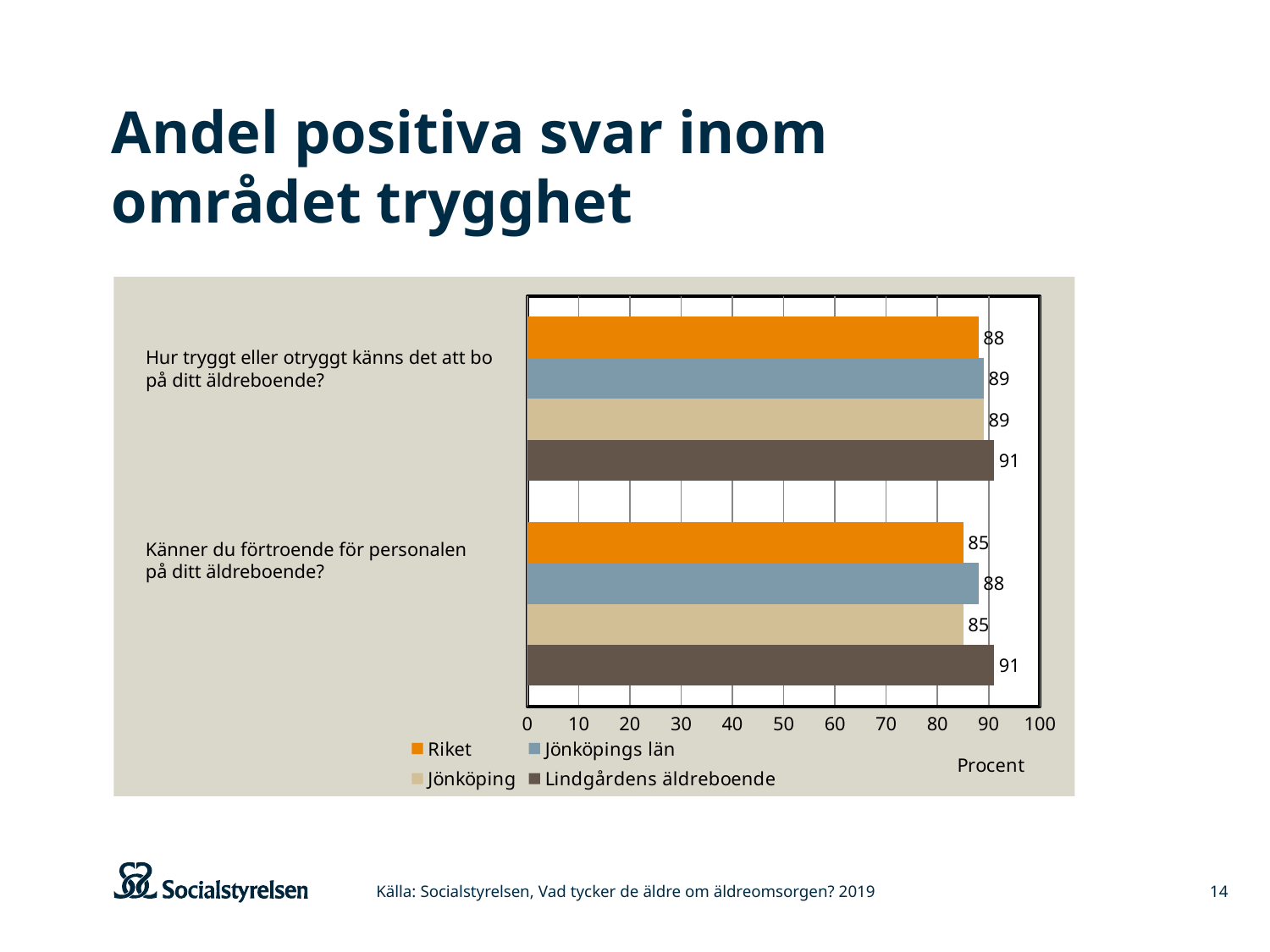
What is the value for Riket for the question "Hur tryggt eller otryggt känns det att bo på ditt äldreboende?"? 88 What unit label is shown under the x axis? Procent Which series has the lowest value for the question "Hur tryggt eller otryggt känns det att bo på ditt äldreboende?"? Riket What is the value for Lindgårdens äldreboende for the question "Känner du förtroende för personalen på ditt äldreboende?"? 91 Which is larger for the question "Känner du förtroende för personalen på ditt äldreboende?": Jönköpings län or Jönköping? Jönköpings län What is the difference between Lindgårdens äldreboende and Riket for the question "Känner du förtroende för personalen på ditt äldreboende?"? 6 Is the value for Riket for the question "Känner du förtroende för personalen på ditt äldreboende?" greater or less than 90? less What type of chart is shown on the slide? bar chart How many question categories are shown on the y axis? 2 What is the value for Jönköpings län for the question "Känner du förtroende för personalen på ditt äldreboende?"? 88 Which series has the highest value for the question "Känner du förtroende för personalen på ditt äldreboende?"? Lindgårdens äldreboende How many series does the legend list? 4